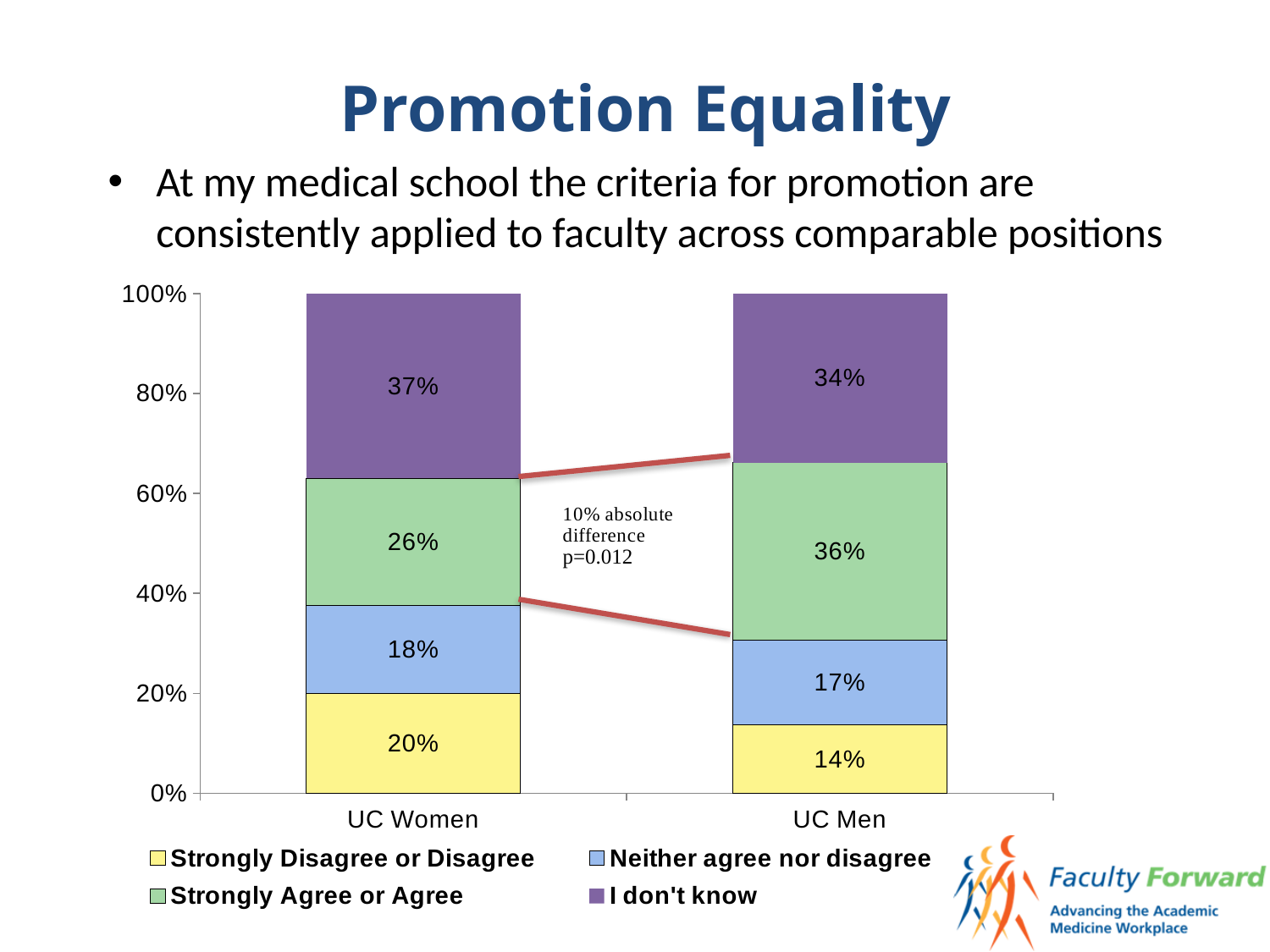
What percentage of UC Men responded 'Strongly Disagree or Disagree'? 14% Which response category is the largest for UC Women? I don't know Which response category is the smallest for UC Men? Strongly Disagree or Disagree Which group has the higher 'Strongly Agree or Agree' percentage, UC Women or UC Men? UC Men How many series does the legend list? 4 What percentage of UC Women responded 'Strongly Agree or Agree'? 26% What is the difference between the 'Strongly Agree or Agree' percentages for UC Men and UC Women? 10% What kind of chart is shown on the slide? Stacked bar chart How many groups are shown on the x axis? 2 What is the difference between the 'Strongly Disagree or Disagree' percentages for UC Women and UC Men? 6% What percentage of UC Women responded 'Neither agree nor disagree'? 18% What percentage of UC Men responded 'I don't know'? 34%